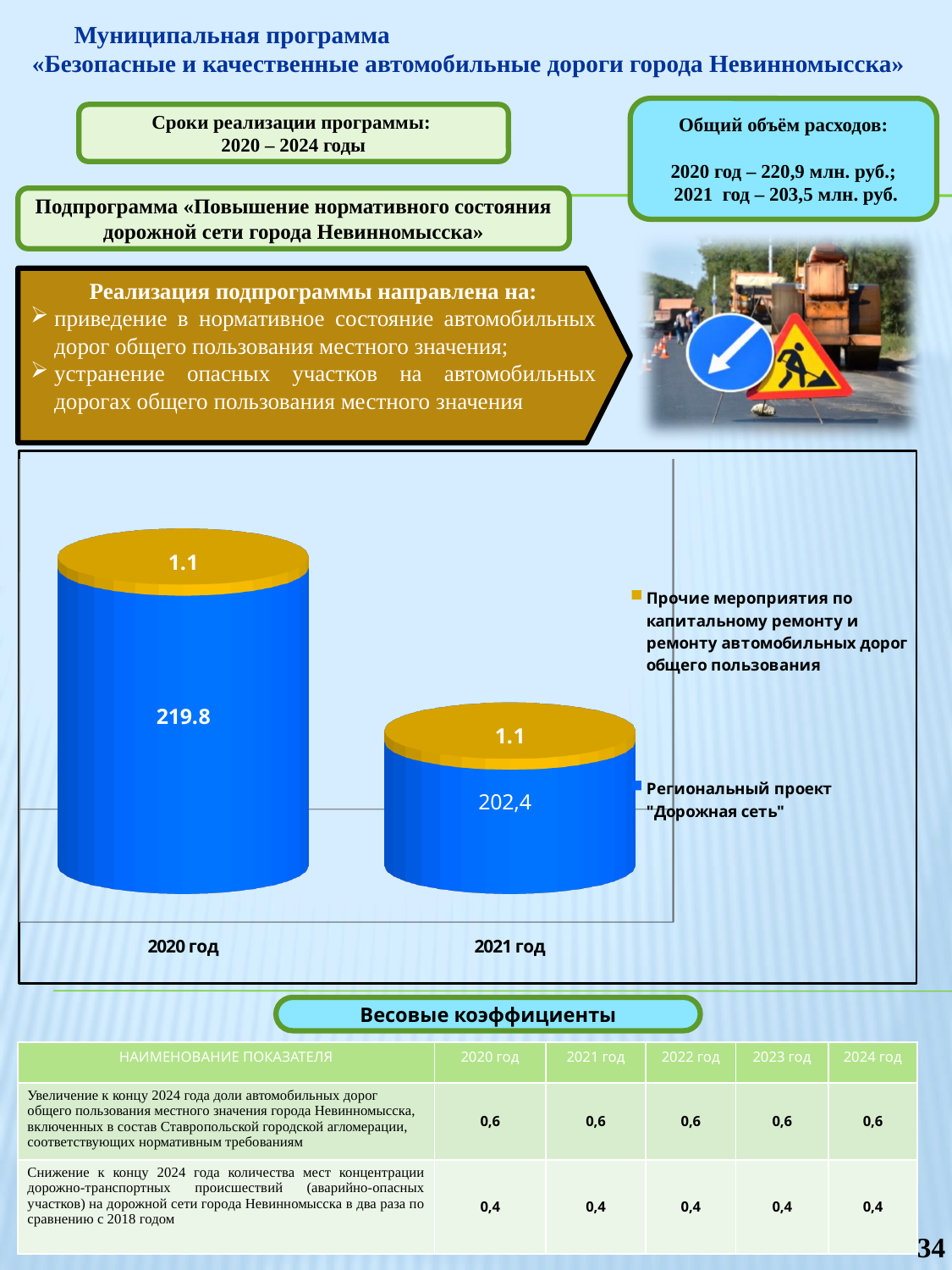
Which year has the higher value for Региональный проект "Дорожная сеть"? 2020 год Is the value for Региональный проект "Дорожная сеть" larger in 2020 год or in 2021 год? 2020 год What is the value for Прочие мероприятия по капитальному ремонту и ремонту автомобильных дорог общего пользования in 2020 год? 1.1 What is the total of the stacked bar for 2021 год? 203,5 What is the total of the stacked bar for 2020 год? 220.9 What kind of chart is shown on the slide? Stacked bar chart What is the value for Региональный проект "Дорожная сеть" in 2021 год? 202,4 How many categories (years) are shown on the x axis of the chart? 2 What is the value for Прочие мероприятия по капитальному ремонту и ремонту автомобильных дорог общего пользования in 2021 год? 1.1 What is the difference between the Региональный проект "Дорожная сеть" values for 2020 год and 2021 год? 17.4 What is the value for Региональный проект "Дорожная сеть" in 2020 год? 219.8 How many series does the chart legend list? 2